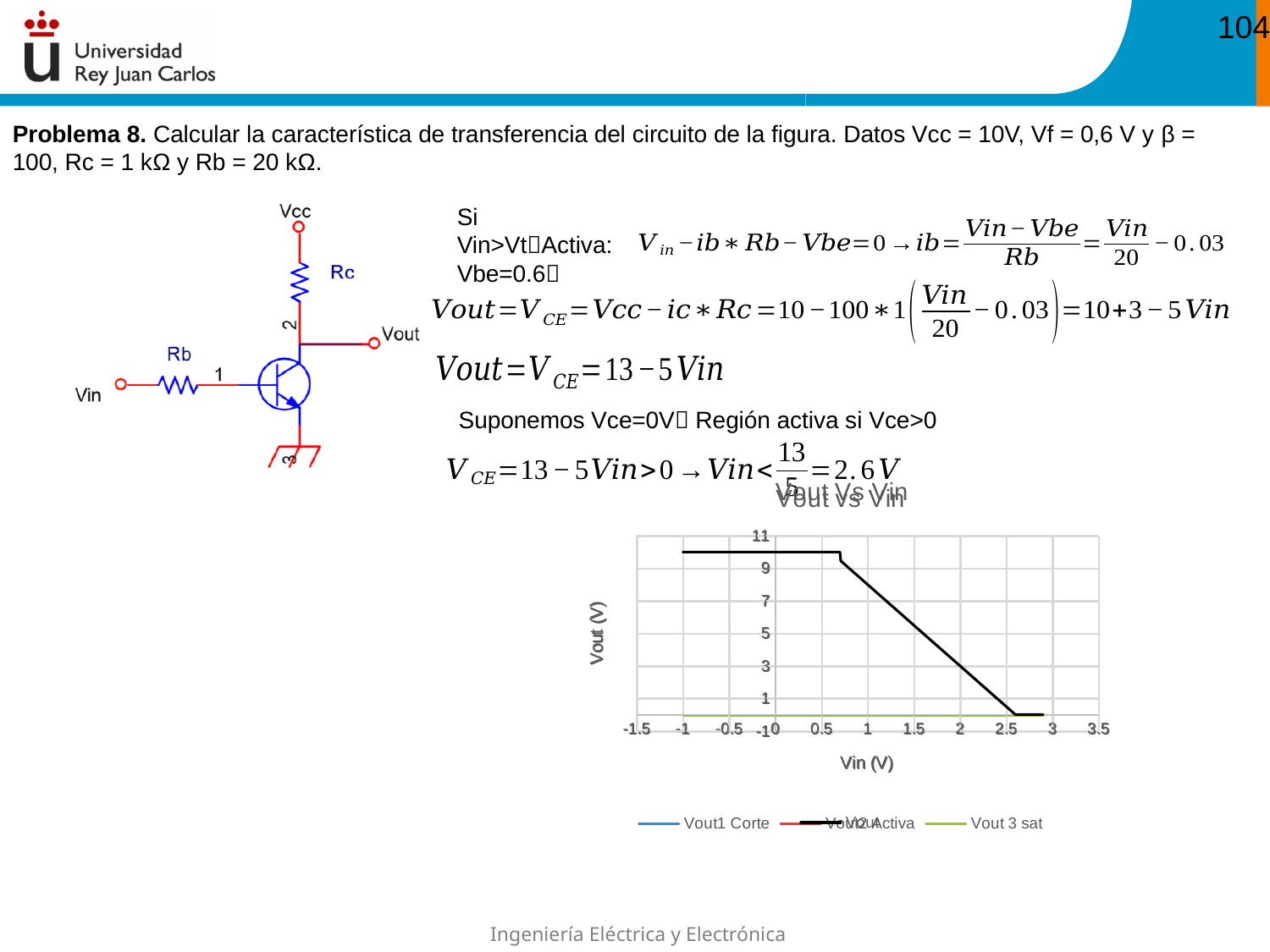
What is the title of the chart on the slide? Vout Vs Vin What is the label of the x axis of the chart? Vin (V) Is the value of Vout at Vin = 1 greater or less than 7? greater How many series does the chart legend list? 3 Between Vin = 1 and Vin = 2.5, does Vout rise or fall as Vin increases? fall Which is larger, Vout at Vin = 0 or Vout at Vin = 2? Vout at Vin = 0 Is the value of Vout at Vin = 2 greater or less than 5? less Is the value of Vout at Vin = -1 greater or less than 9? greater What kind of chart is shown on the slide? line chart